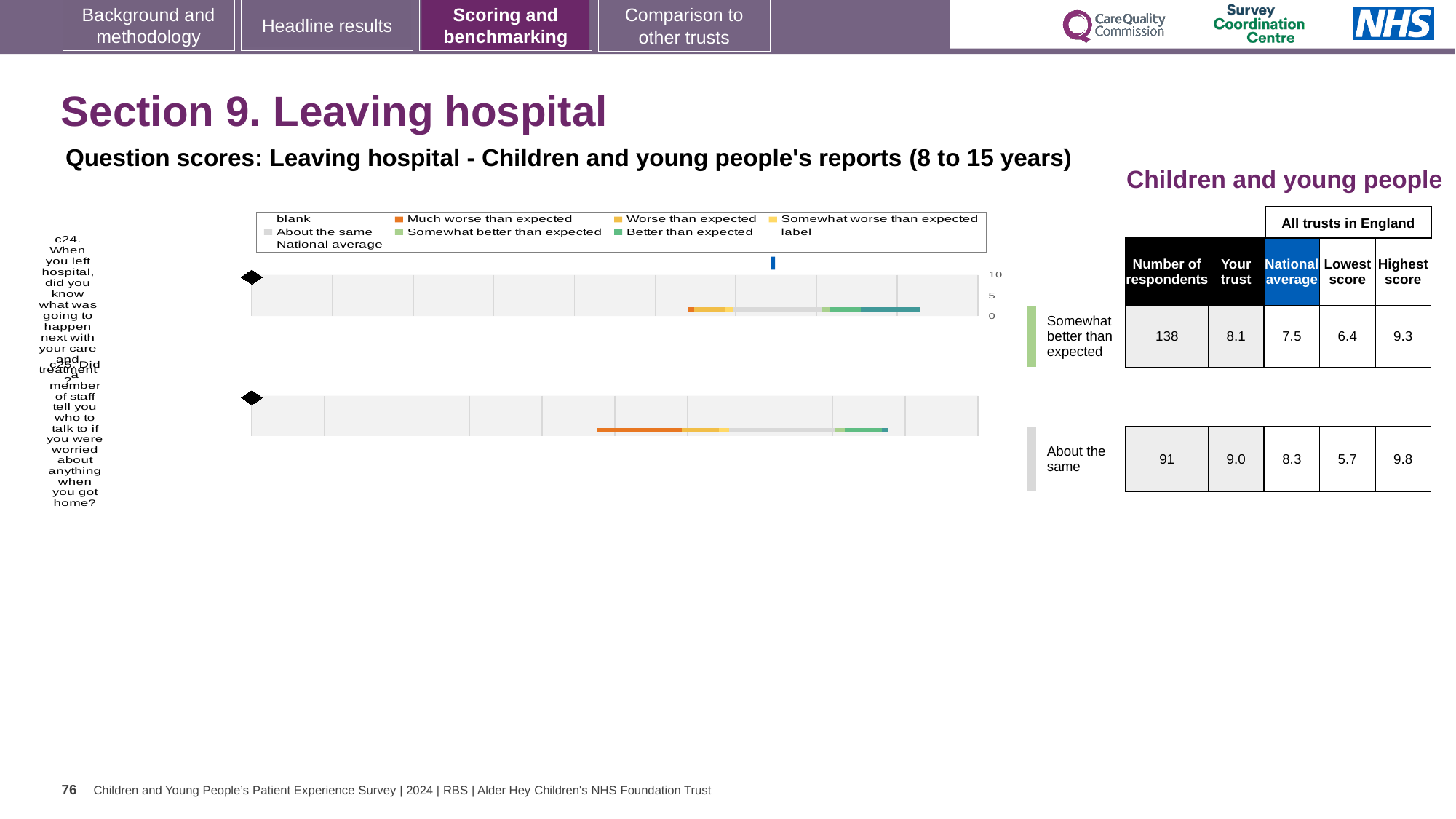
What is the national average score for question c24? 7.5 What is the difference in the number of respondents between question c24 and question c25? 47 Which benchmark category is question c25 placed in? About the same Which question has the higher 'Your trust' score, c24 or c25? c25 What is the 'Your trust' score for question c24 (When you left hospital, did you know what was going to happen next with your care and treatment?)? 8.1 What is the highest score among all trusts in England for question c25? 9.8 How many survey questions are charted on the slide? 2 What kind of chart is used to show the question scores? Bar chart How many respondents answered question c25 (Did a member of staff tell you who to talk to if you were worried about anything when you got home?)? 91 What is the lowest score among all trusts in England for question c24? 6.4 By how much does the trust's score for question c25 exceed the national average? 0.7 Which benchmark category is question c24 placed in? Somewhat better than expected